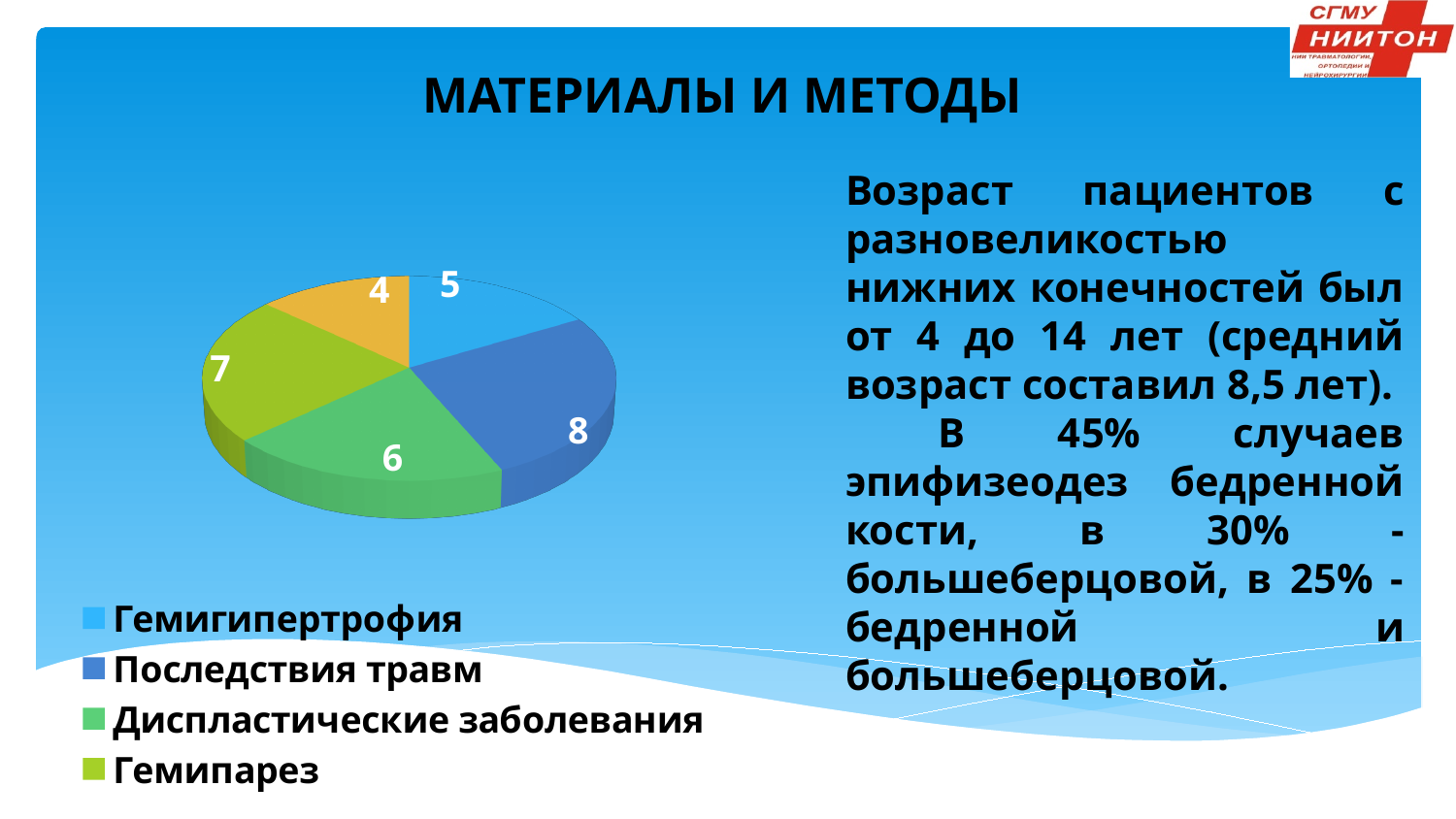
Which is larger, the value for Гемипарез or the value for Диспластические заболевания? Гемипарез What kind of chart is shown on the slide? pie chart What colour is the slice for Гемигипертрофия in the pie chart? light blue What is the value for Гемипарез in the pie chart? 7 What is the total of all the values labelled on the pie chart? 30 How many slices does the pie chart have? 5 Which category has the largest slice in the pie chart? Последствия травм What is the difference between the values for Последствия травм and Гемигипертрофия? 3 What is the value for Последствия травм in the pie chart? 8 What is the value for Гемигипертрофия in the pie chart? 5 What is the value for Диспластические заболевания in the pie chart? 6 What is the smallest value labelled on the pie chart? 4